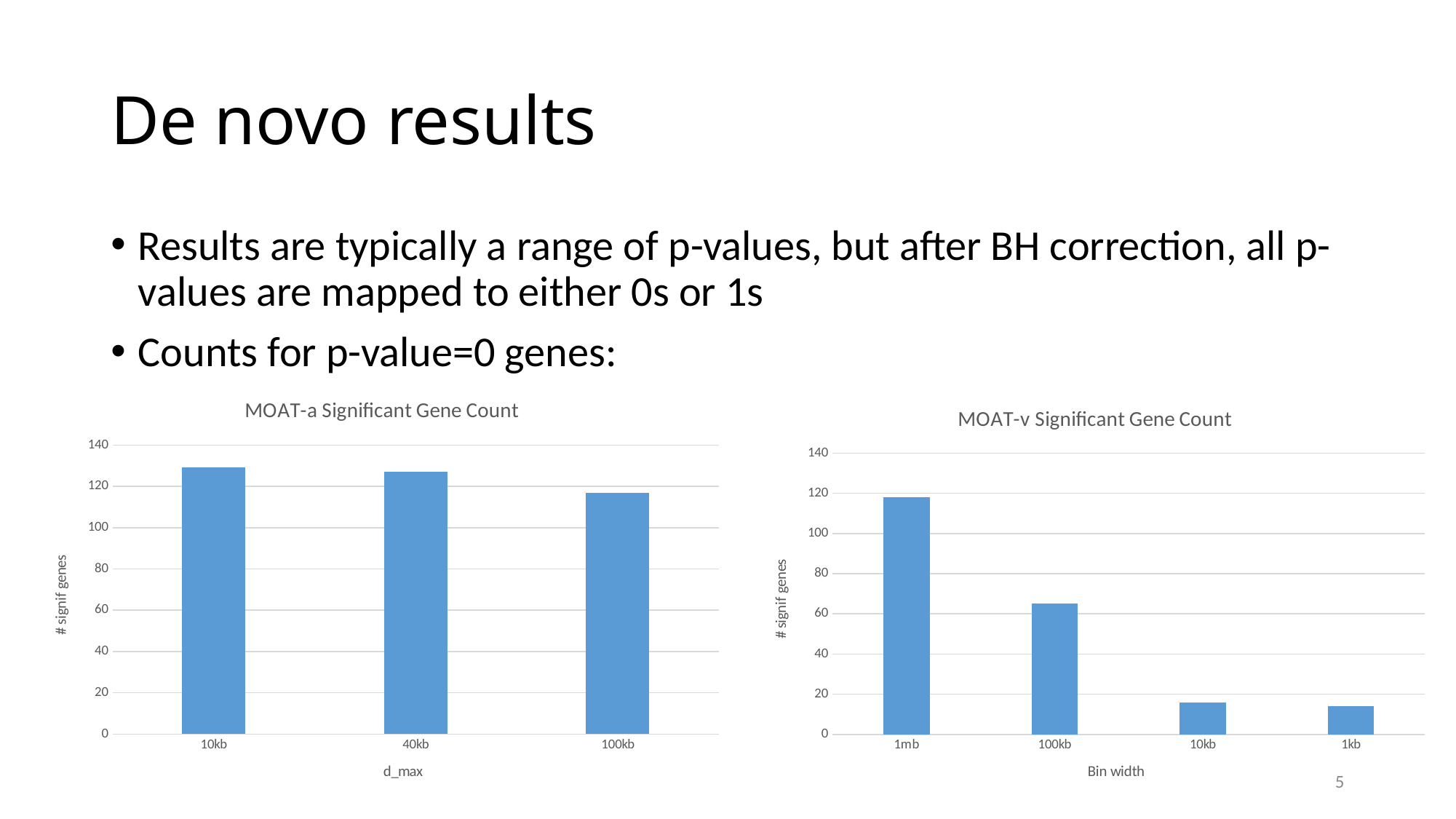
What kind of chart is the MOAT-a Significant Gene Count chart? bar chart In the MOAT-a Significant Gene Count chart, is the value for 100kb greater or less than 120? less In the MOAT-v Significant Gene Count chart, which bin width has the highest number of significant genes? 1mb In the MOAT-v Significant Gene Count chart, how many bin width categories are shown? 4 What is the y-axis label of the MOAT-v Significant Gene Count chart? # signif genes In the MOAT-a Significant Gene Count chart, which d_max category has the lowest number of significant genes? 100kb In the MOAT-a Significant Gene Count chart, how many d_max categories are shown? 3 In the MOAT-v Significant Gene Count chart, is the value for 1kb greater or less than 20? less In the MOAT-v Significant Gene Count chart, which is larger, the value for 1mb or the value for 100kb? 1mb In the MOAT-v Significant Gene Count chart, is the value for 100kb greater or less than 60? greater In the MOAT-a Significant Gene Count chart, do the values rise or fall from 10kb to 100kb? fall